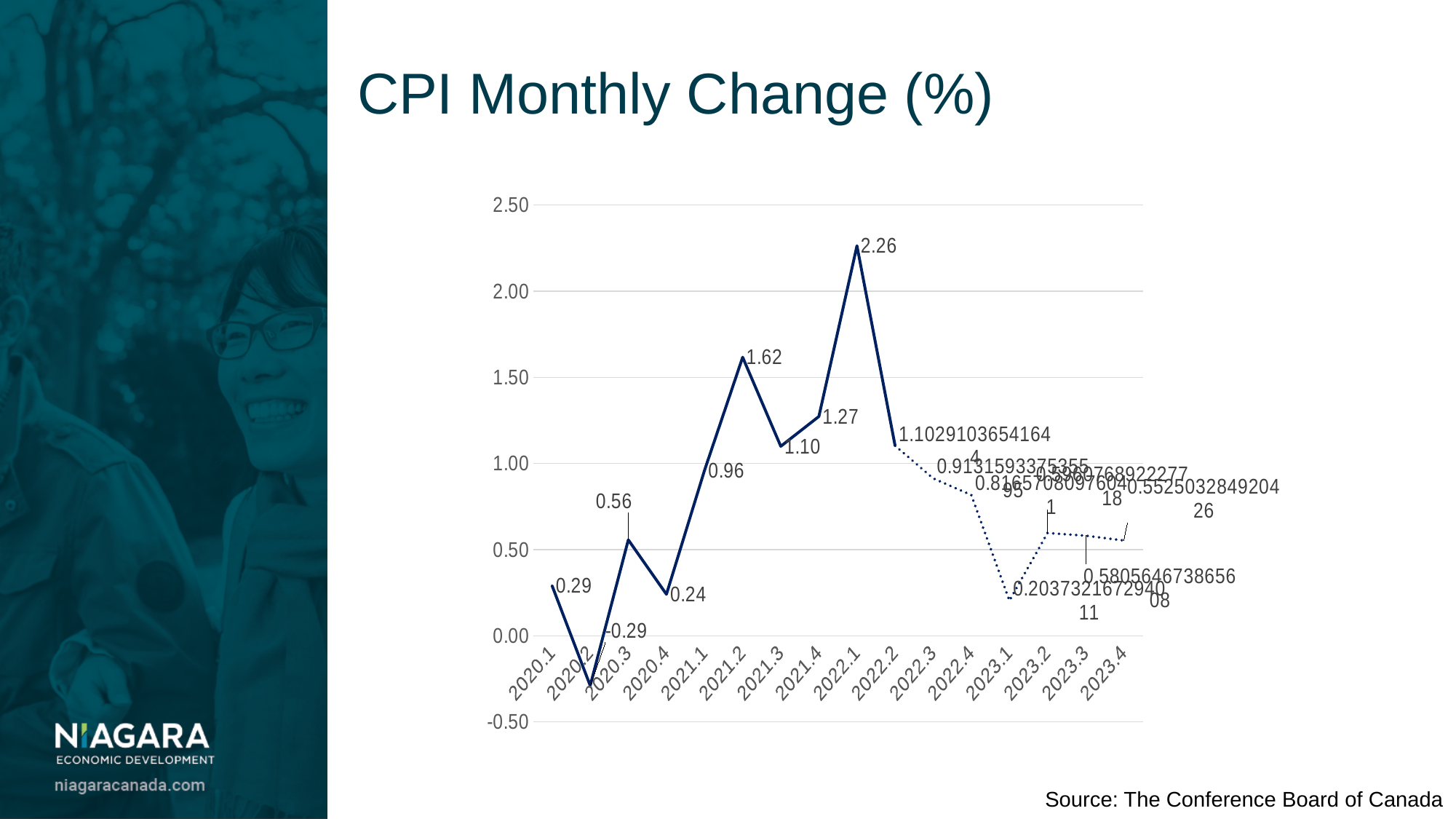
What is the CPI monthly change for 2020.1? 0.29 How many periods are plotted on the x axis? 16 Which is larger, the value for 2021.4 or the value for 2021.3? 2021.4 What is the CPI monthly change for 2020.3? 0.56 Which period has the highest CPI monthly change? 2022.1 What is the CPI monthly change for 2021.2? 1.62 What is the title of the chart? CPI Monthly Change (%) What kind of chart is shown on the slide? line chart Is the value for 2023.1 greater or less than 0.50? less Is the value for 2022.3 greater or less than 1.00? less Which period has the lowest CPI monthly change? 2020.2 What is the difference between the values for 2022.1 and 2021.2? 0.64